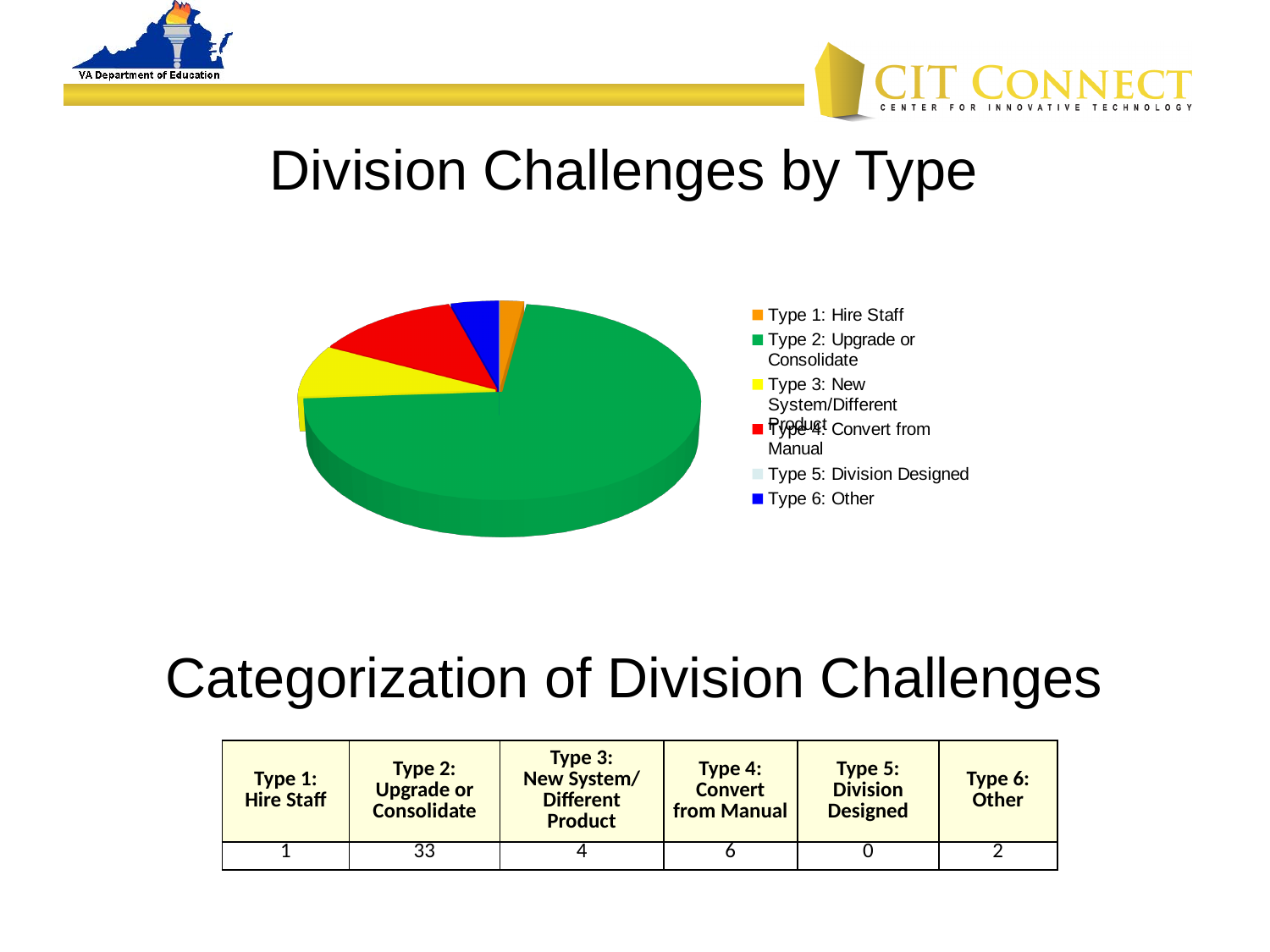
What is the title of the pie chart on the slide? Division Challenges by Type According to the "Categorization of Division Challenges" table, how many challenges are Type 5: Division Designed? 0 According to the "Categorization of Division Challenges" table, how many challenges are Type 1: Hire Staff? 1 Which is larger in the "Categorization of Division Challenges" table: Type 3: New System/Different Product or Type 6: Other? Type 3: New System/Different Product Which type has the largest slice in the "Division Challenges by Type" pie chart? Type 2: Upgrade or Consolidate According to the "Categorization of Division Challenges" table, how many challenges are Type 2: Upgrade or Consolidate? 33 What colour represents Type 4: Convert from Manual in the "Division Challenges by Type" pie chart? Red According to the "Categorization of Division Challenges" table, how many challenges are Type 4: Convert from Manual? 6 Using the "Categorization of Division Challenges" table, what is the difference between the Type 2 and Type 4 counts? 27 How many entries does the legend of the "Division Challenges by Type" pie chart list? 6 What kind of chart is shown under the title "Division Challenges by Type"? Pie chart Which type has the smallest value in the "Categorization of Division Challenges" table? Type 5: Division Designed